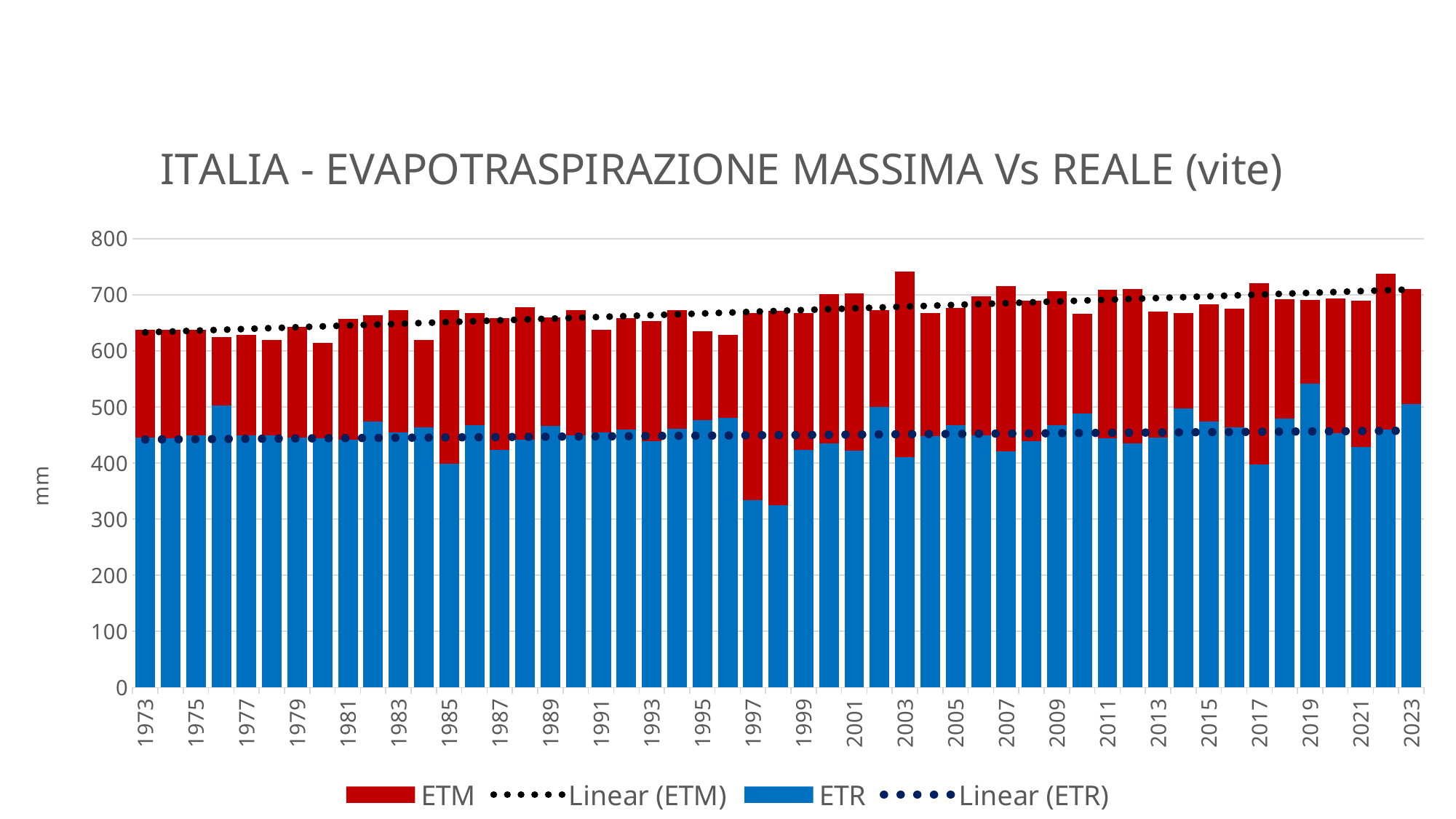
Is the ETM value for 1980 greater or less than 600? greater Is the ETM value for 2003 greater or less than 700? greater How many years are plotted along the x axis, from 1973 to 2023? 51 What is the title of the chart? ITALIA - EVAPOTRASPIRAZIONE MASSIMA Vs REALE (vite) Does the Linear (ETM) trend line rise or fall from 1973 to 2023? rise Which year has the highest ETR value? 2019 Is the ETR value for 2019 greater or less than 500? greater What kind of chart is shown on the slide? bar chart Which is larger, the ETM value for 2003 or the ETM value for 1973? 2003 What unit is shown on the vertical axis? mm How many entries does the legend list? 4